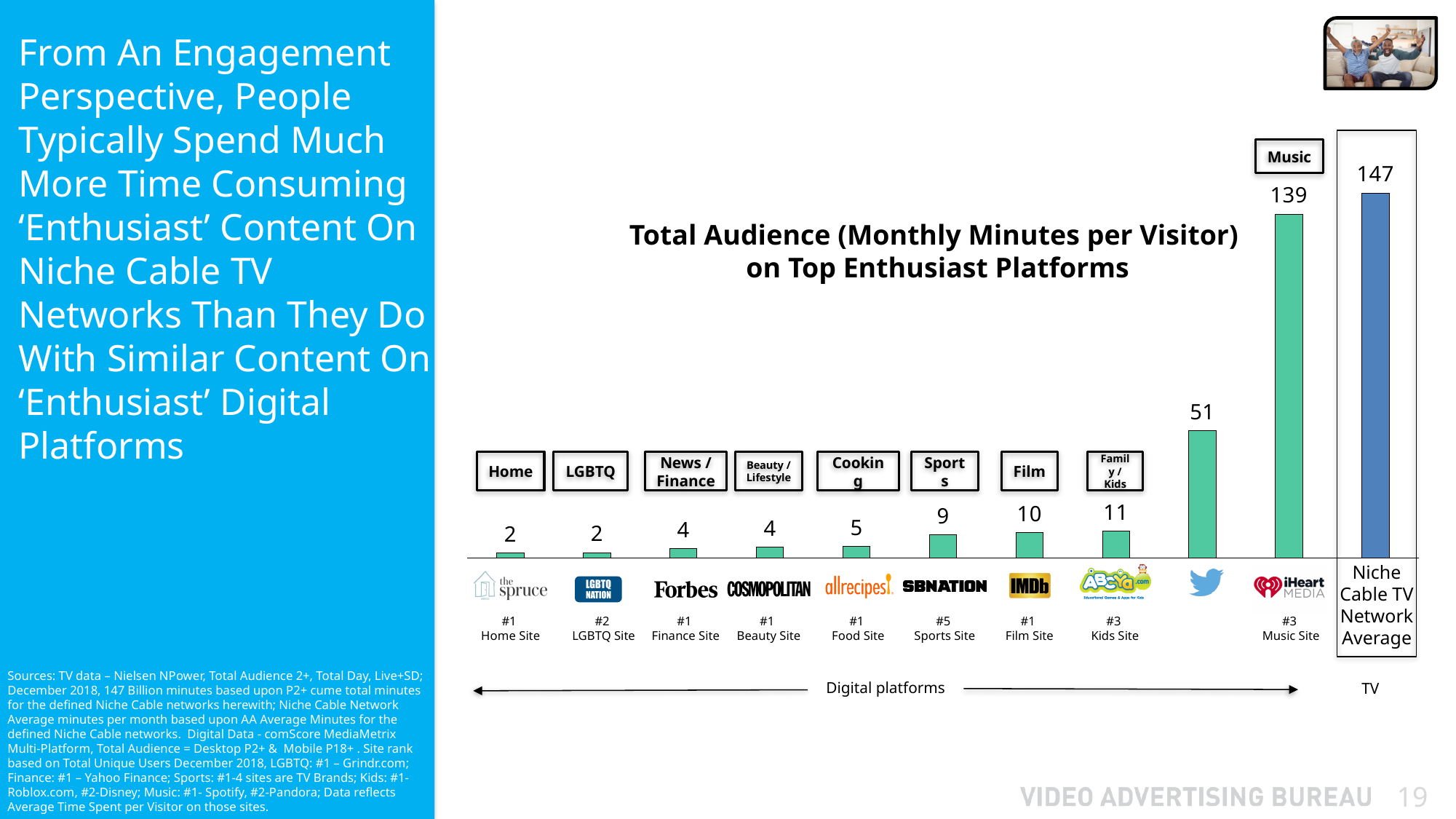
Which category has the highest monthly minutes per visitor? Niche Cable TV Network Average Which is larger, the value for the #1 Food Site or the #1 Beauty Site? #1 Food Site What is the value for the Niche Cable TV Network Average bar? 147 How many bars are plotted in the chart? 11 What is the value for the #5 Sports Site (SBNation)? 9 What is the value for the #1 Finance Site (Forbes)? 4 What is the title of the chart? Total Audience (Monthly Minutes per Visitor) on Top Enthusiast Platforms What is the value for the #1 Film Site (IMDb)? 10 What is the difference between the #3 Kids Site and the #1 Home Site? 9 What kind of chart is shown on the slide? Bar chart What is the value for the #3 Music Site (iHeart Media)? 139 What is the difference between the Niche Cable TV Network Average and the #3 Music Site? 8